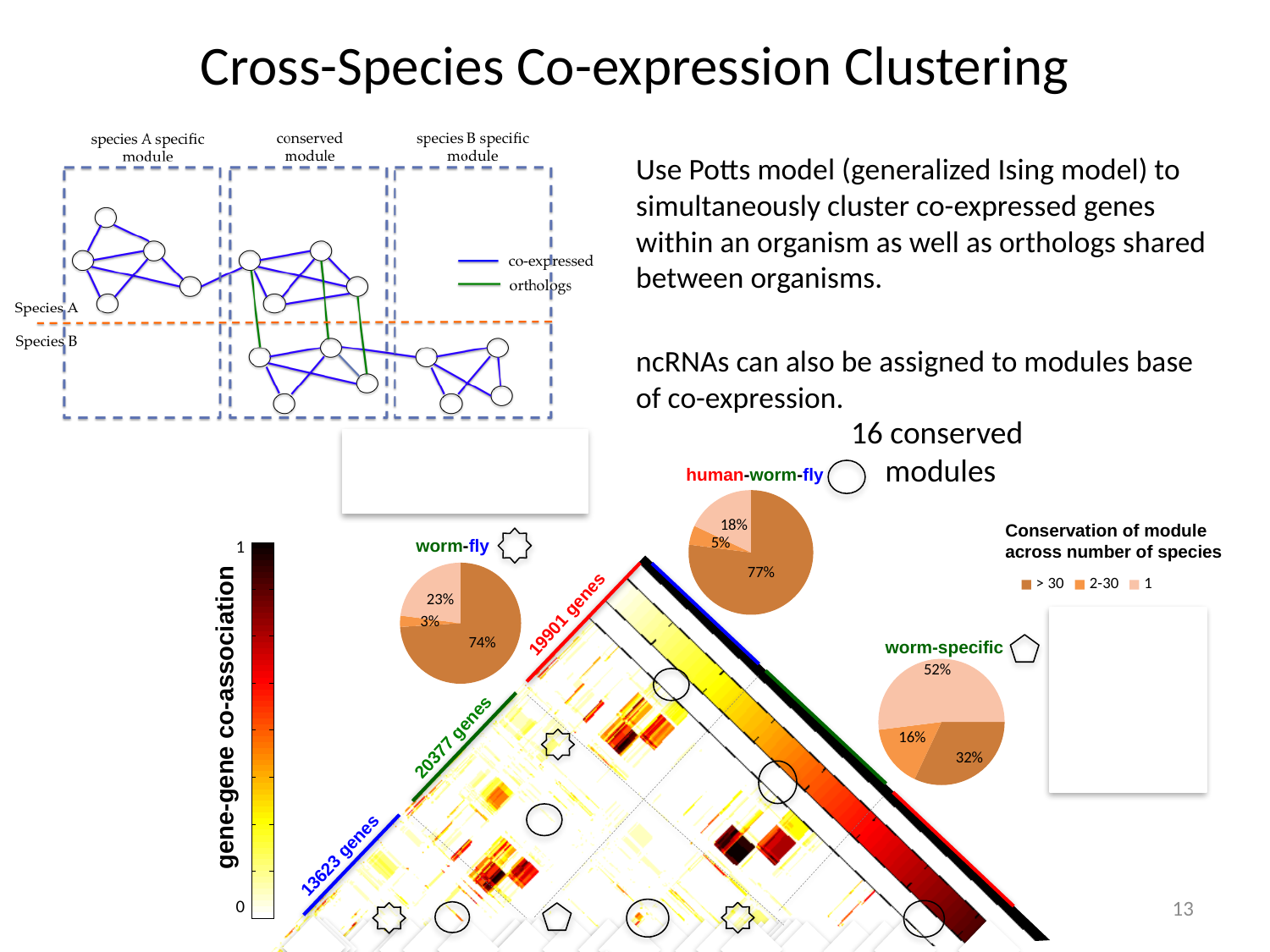
In the human-worm-fly pie chart, what is the smallest slice's value? 5% In the worm-specific pie chart, what is the largest slice's value? 52% In the worm-specific pie chart, what is the smallest slice's value? 16% How many categories does the legend 'Conservation of module across number of species' list? 3 In the worm-specific pie chart, what is the difference between the 52% slice and the 32% slice? 20% In the human-worm-fly pie chart, what is the largest slice's value? 77% In the worm-fly pie chart, what percentage is shown for the largest slice? 74% How many slices does the worm-fly pie chart have? 3 In the worm-fly pie chart, what is the smallest slice's value? 3% What type of chart is used to show the worm-specific module conservation? pie chart Which is larger: the largest slice of the worm-fly pie chart or the largest slice of the worm-specific pie chart? worm-fly (74%) In the human-worm-fly pie chart, what is the difference between the 18% slice and the 5% slice? 13%